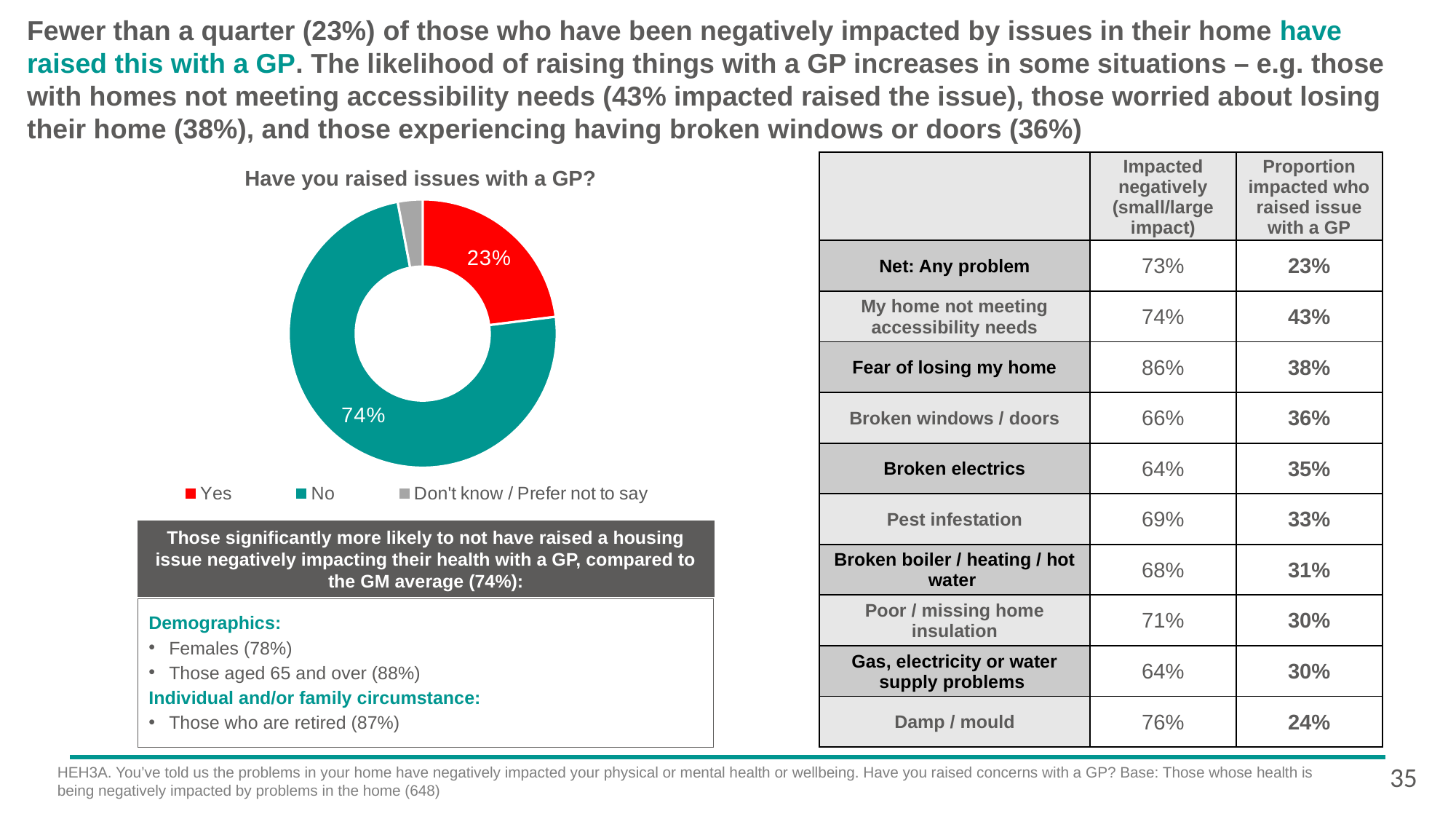
Which response has the largest slice in the chart 'Have you raised issues with a GP?'? No In the chart 'Have you raised issues with a GP?', what percentage of respondents answered Yes? 23% What share of the pie in 'Have you raised issues with a GP?' is taken by the Yes response? 23% How many entries does the legend of the chart 'Have you raised issues with a GP?' list? 3 What is the title of the pie chart on the slide? Have you raised issues with a GP? How many slices does the chart 'Have you raised issues with a GP?' have? 3 In the chart 'Have you raised issues with a GP?', which is larger: the Yes slice or the No slice? No In the chart 'Have you raised issues with a GP?', what colour represents the Yes response? Red In the chart 'Have you raised issues with a GP?', how many percentage points larger is the No slice than the Yes slice? 51 percentage points What kind of chart is used for 'Have you raised issues with a GP?'? Pie chart (donut) In the chart 'Have you raised issues with a GP?', what percentage of respondents answered No? 74% Which response has the smallest slice in the chart 'Have you raised issues with a GP?'? Don't know / Prefer not to say